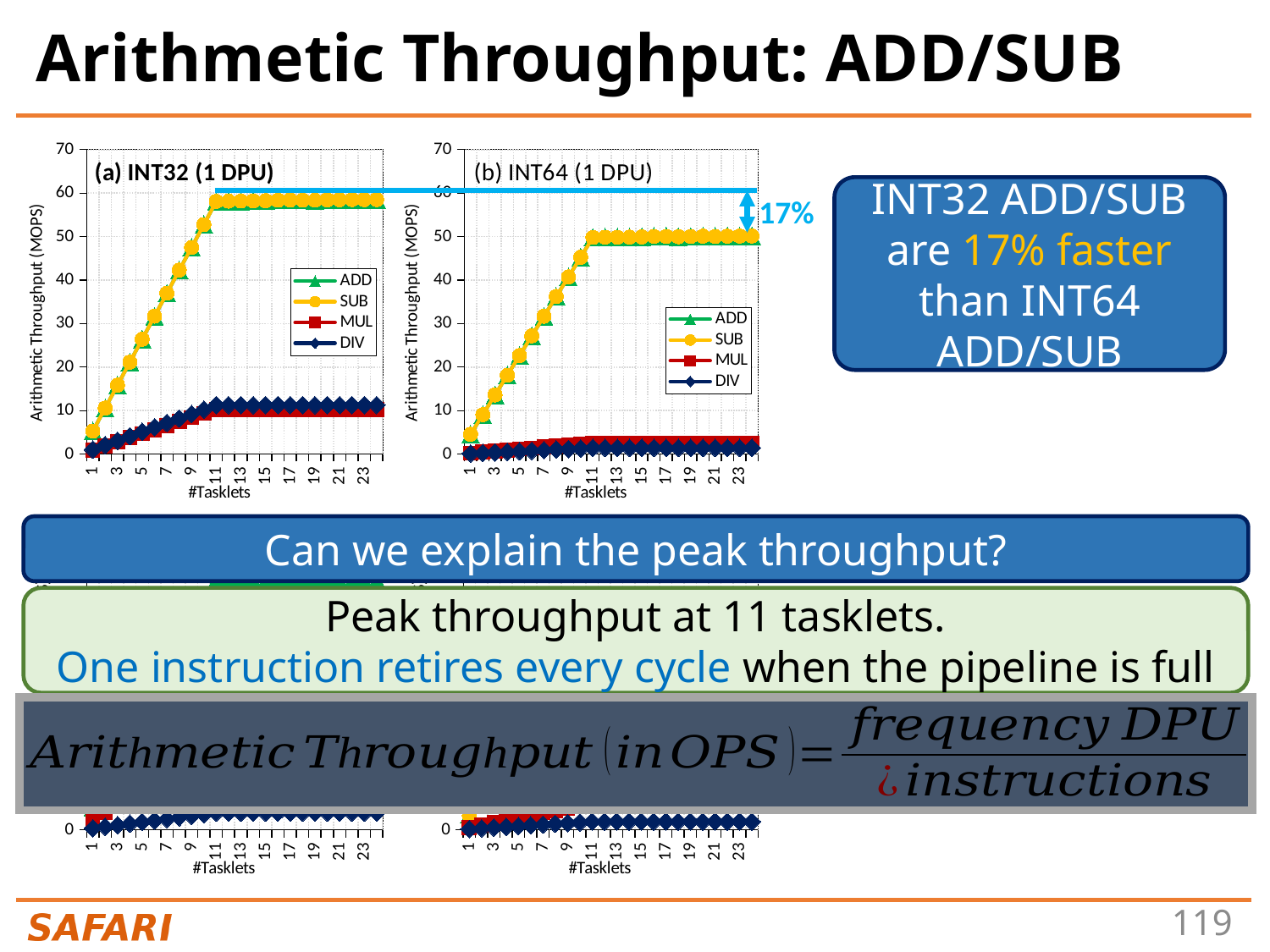
What is the x-axis label of the (b) INT64 (1 DPU) chart? #Tasklets In the (b) INT64 (1 DPU) chart, is the MUL value at 23 tasklets greater or less than 10? less In the (a) INT32 (1 DPU) chart, is the SUB value at 1 tasklet greater or less than 10? less Which chart reaches a higher plateau for ADD: (a) INT32 (1 DPU) or (b) INT64 (1 DPU)? (a) INT32 (1 DPU) In the (a) INT32 (1 DPU) chart, which is larger at 23 tasklets: ADD or DIV? ADD In the (b) INT64 (1 DPU) chart, does the SUB series rise or fall as the number of tasklets increases from 1 to 11? rise What kind of chart is the (a) INT32 (1 DPU) chart? line chart What is the y-axis label of the (a) INT32 (1 DPU) chart? Arithmetic Throughput (MOPS) How many series does the legend of the (b) INT64 (1 DPU) chart list? 4 In the (a) INT32 (1 DPU) chart, is the DIV value at 23 tasklets greater or less than 20? less